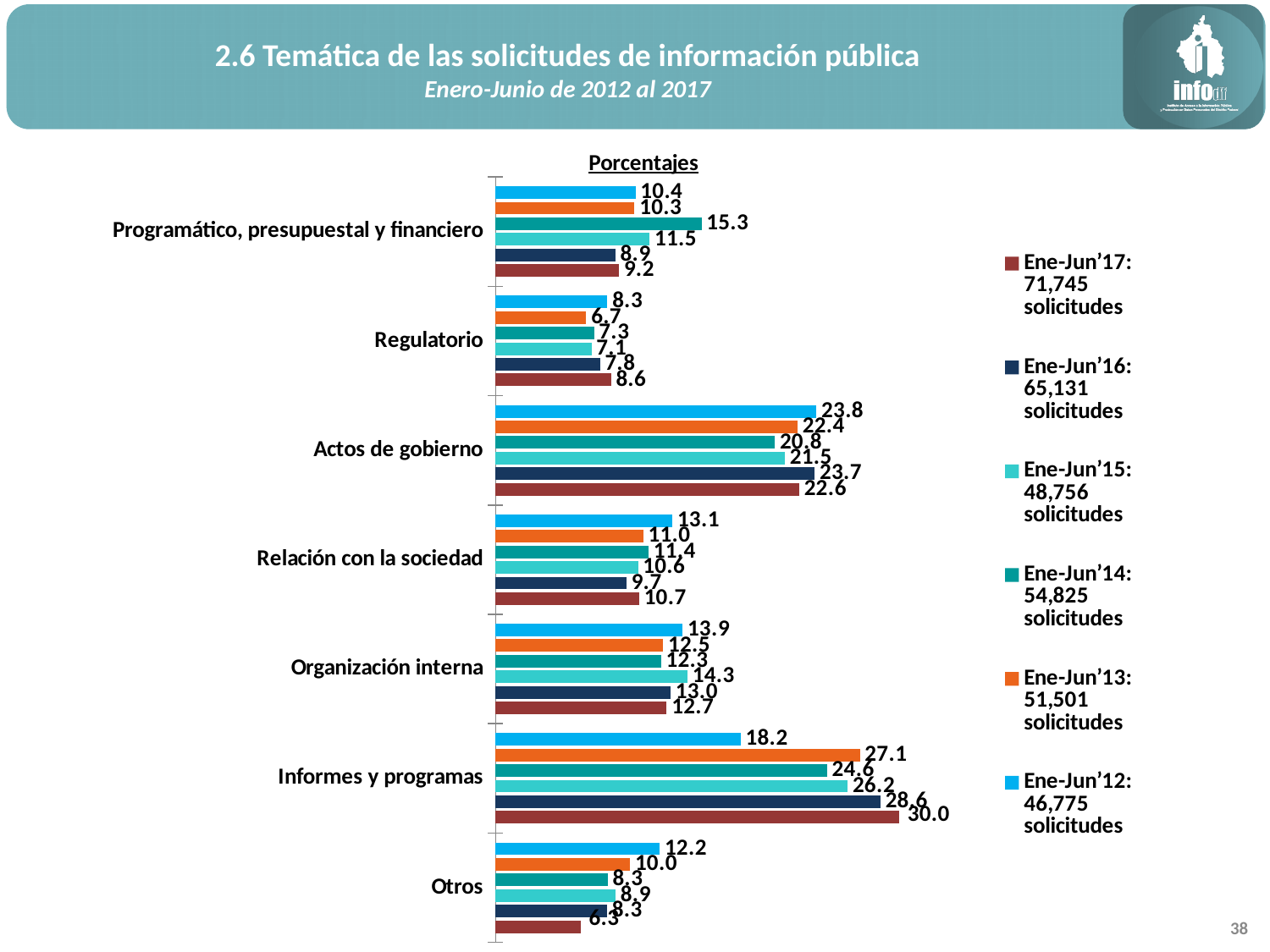
Which is larger for Otros: the Ene-Jun'12 value or the Ene-Jun'17 value? Ene-Jun'12 How many series does the legend list? 6 What is the percentage for Informes y programas in Ene-Jun'17? 30.0 What is the difference between the Ene-Jun'17 and Ene-Jun'12 percentages for Informes y programas? 11.8 How many solicitudes does the legend give for Ene-Jun'17? 71,745 What kind of chart is shown on the slide? Bar chart What is the percentage for Programático, presupuestal y financiero in Ene-Jun'14? 15.3 What is the percentage for Actos de gobierno in Ene-Jun'12? 23.8 What is the difference between the Ene-Jun'15 and Ene-Jun'14 percentages for Organización interna? 2.0 Which category has the lowest percentage in Ene-Jun'13? Regulatorio How many categories (temáticas) are shown on the chart? 7 Which category has the highest percentage in Ene-Jun'17? Informes y programas